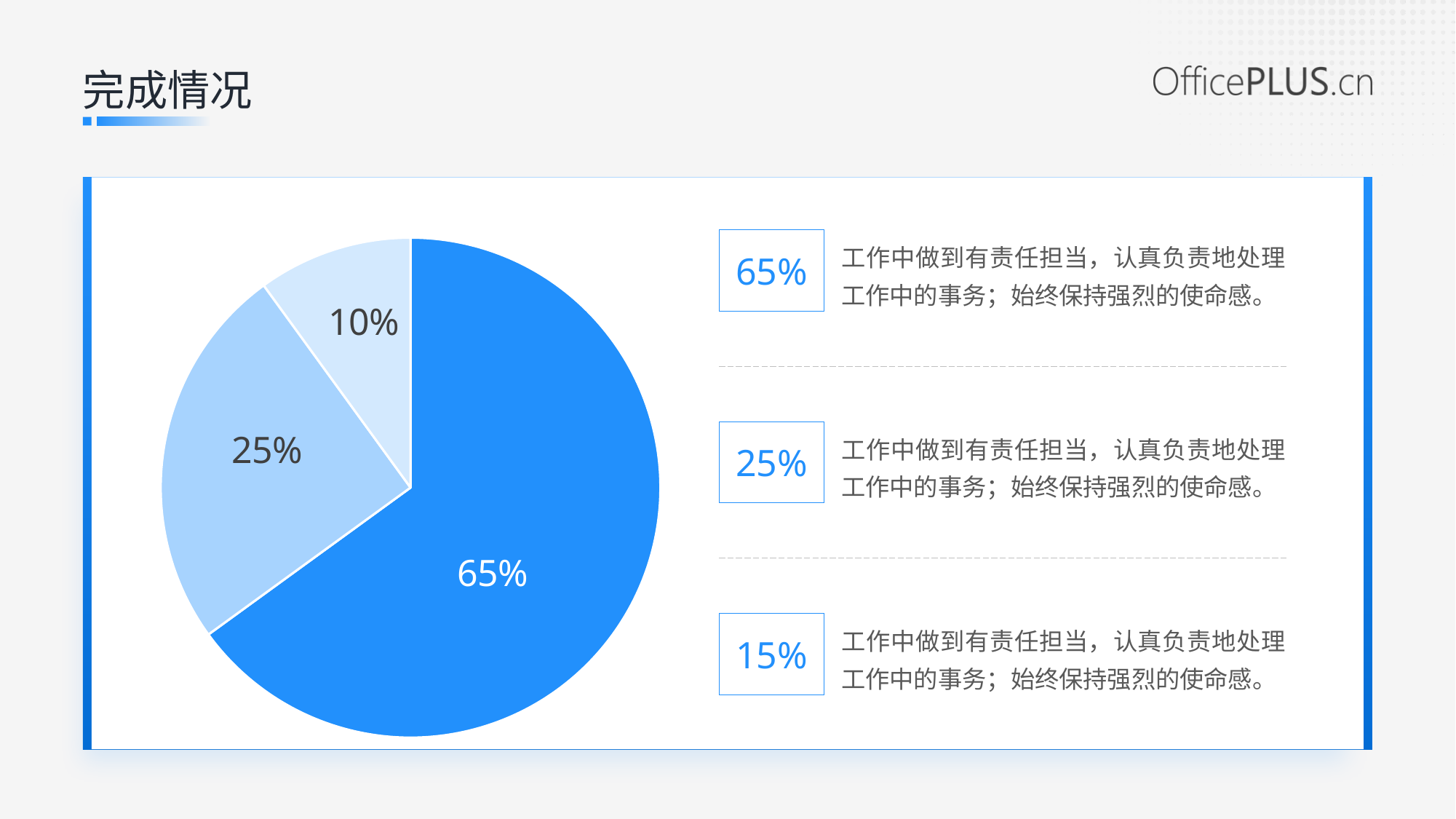
What is the difference in percentage points between the 25% slice and the 10% slice? 15 Is the largest slice of the pie chart greater or less than 50%? greater How many slices does the pie chart have? 3 What value is labelled on the dark blue slice of the pie chart? 65% What is the difference in percentage points between the 65% slice and the 25% slice? 40 Which slice is larger: the dark blue slice or the lightest blue slice? The dark blue slice What value is labelled on the medium light blue slice of the pie chart? 25% What is the value of the largest slice in the pie chart? 65% What is the title of the slide containing the pie chart? 完成情况 What is the value of the smallest slice in the pie chart? 10% What kind of chart is shown on the slide? Pie chart What value is labelled on the lightest blue slice of the pie chart? 10%